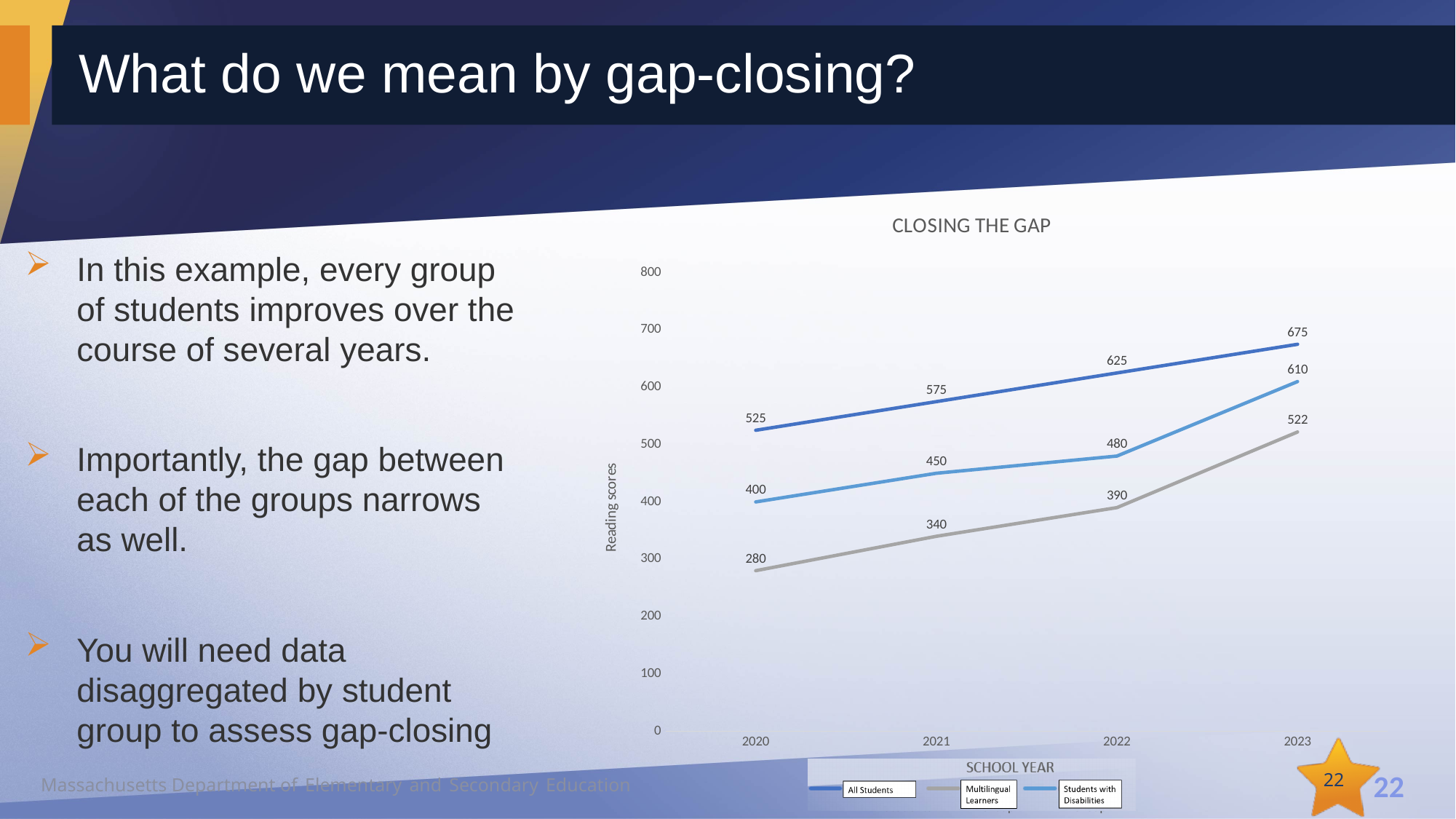
Which is larger in 2023: the Students with Disabilities score or the Multilingual Learners score? Students with Disabilities How many series does the chart's legend list? 3 What is the difference between the All Students score and the Multilingual Learners score in 2020? 245 Do the reading scores for Students with Disabilities rise or fall from 2020 to 2023? rise How many school years are plotted on the x axis? 4 What type of chart is shown on the slide? line chart What is the title of the chart? CLOSING THE GAP What is the reading score for Students with Disabilities in 2022? 480 What is the reading score for All Students in 2023? 675 What is the reading score for Multilingual Learners in 2020? 280 Which student group has the lowest reading score in 2021? Multilingual Learners Which student group has the highest reading score in 2023? All Students